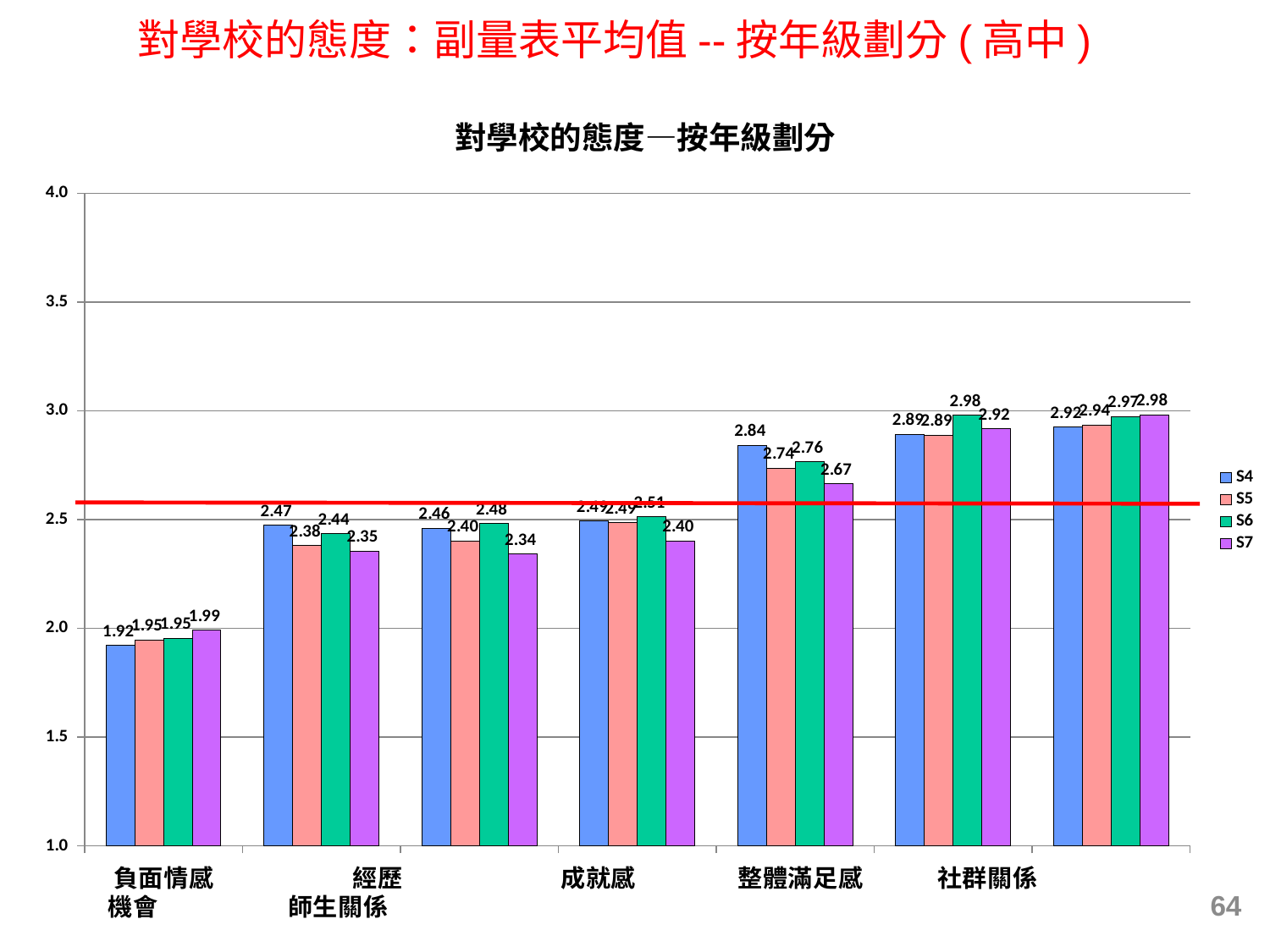
How many series does the legend list? 4 How many categories are shown on the x axis? 7 What type of chart is shown on the slide? bar chart What is the value for S4 in the 負面情感 category? 1.92 Which series has the highest value in the 社群關係 category? S7 What is the title of the chart? 對學校的態度—按年級劃分